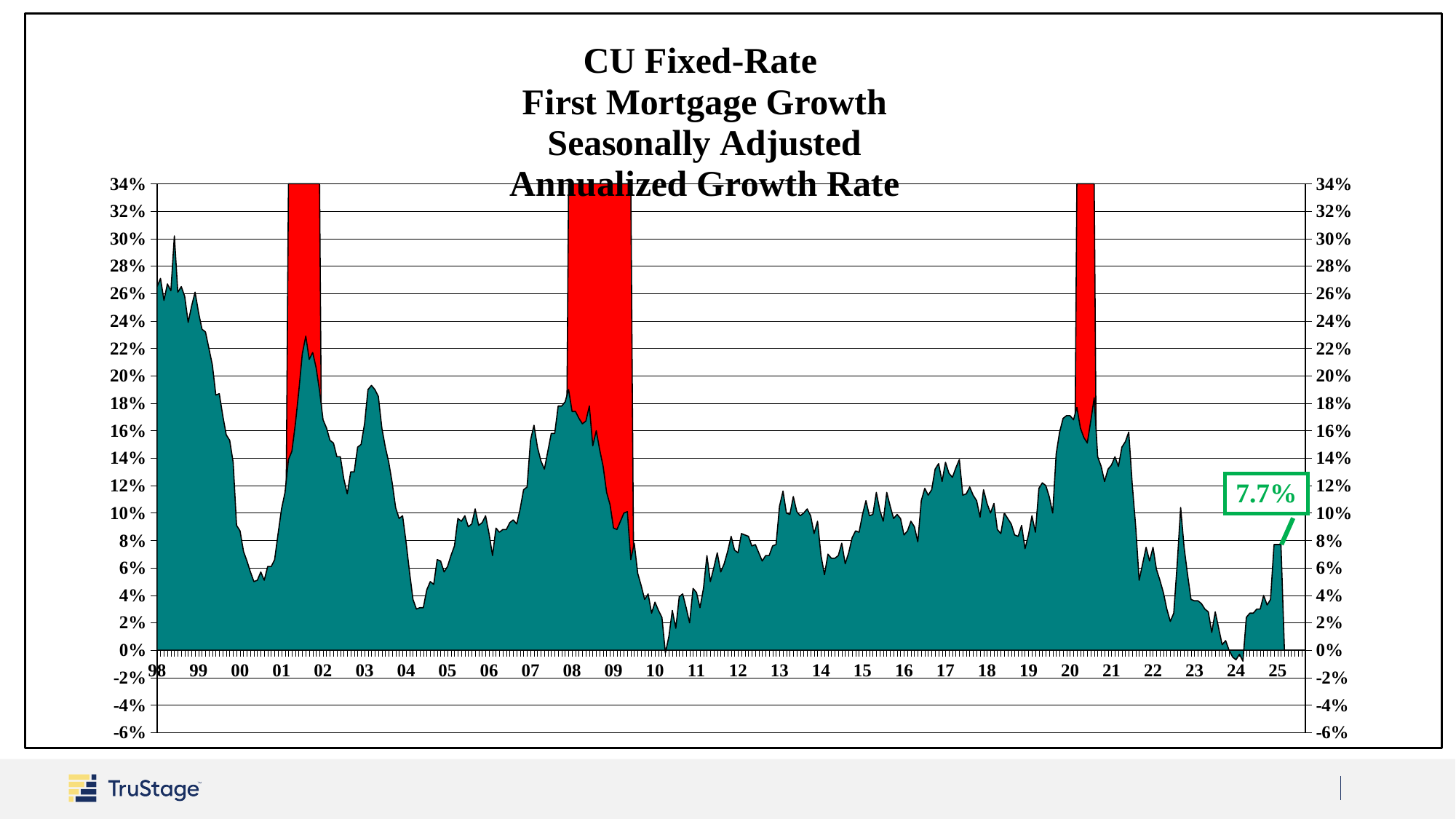
What kind of chart is shown on the slide? Area chart How many red shaded bands are overlaid on the chart? 3 Is the lowest growth rate around 2004 greater or less than 6%? less How many year labels are shown along the x axis? 28 What is the highest value shown on the y axis? 34% In which year does the growth rate reach its highest peak? 1998 What is the value shown by the data label at the end of the series in 2025? 7.7% Is the growth rate at the start of the series in 1998 greater or less than 20%? greater What is the title of the chart? CU Fixed-Rate First Mortgage Growth Seasonally Adjusted Annualized Growth Rate Which is larger, the growth rate in 1998 or the growth rate in 2010? 1998 Is the peak growth rate around 2020 greater or less than 14%? greater